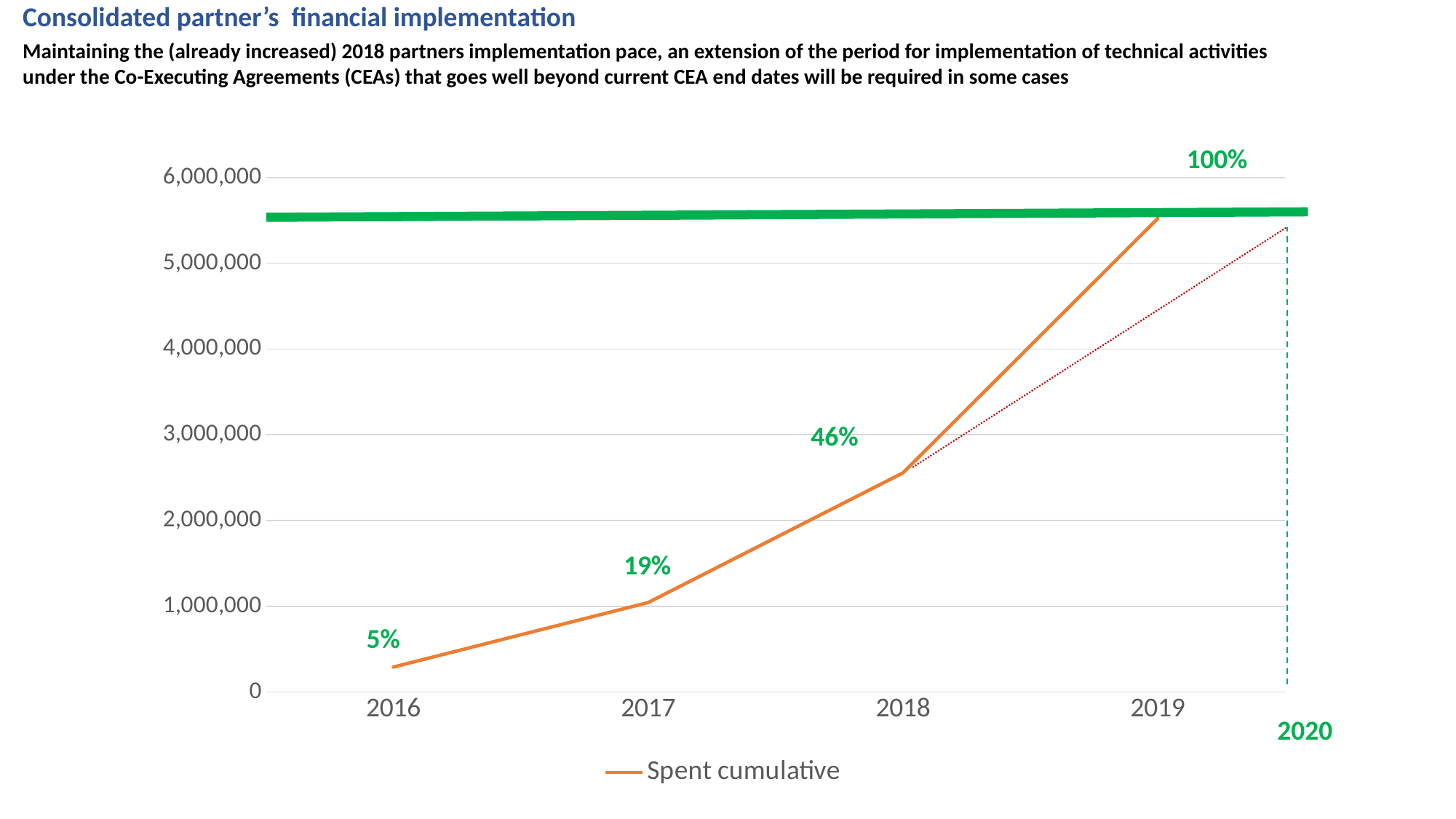
Which year has the lowest Spent cumulative value? 2016 What kind of chart is shown on the slide? line chart What is the name of the series shown in the legend? Spent cumulative Which year has the highest Spent cumulative value? 2019 Is the Spent cumulative value for 2018 greater or less than 2,000,000? greater Is the Spent cumulative value for 2019 greater or less than 5,000,000? greater How many series does the legend list? 1 Which year has a larger Spent cumulative value, 2017 or 2018? 2018 Is the Spent cumulative value for 2016 greater or less than 1,000,000? less What percentage label is shown next to the 2018 point on the chart? 46% What is the title of the slide containing the chart? Consolidated partner's financial implementation Does the Spent cumulative line rise or fall from 2016 to 2019? rise